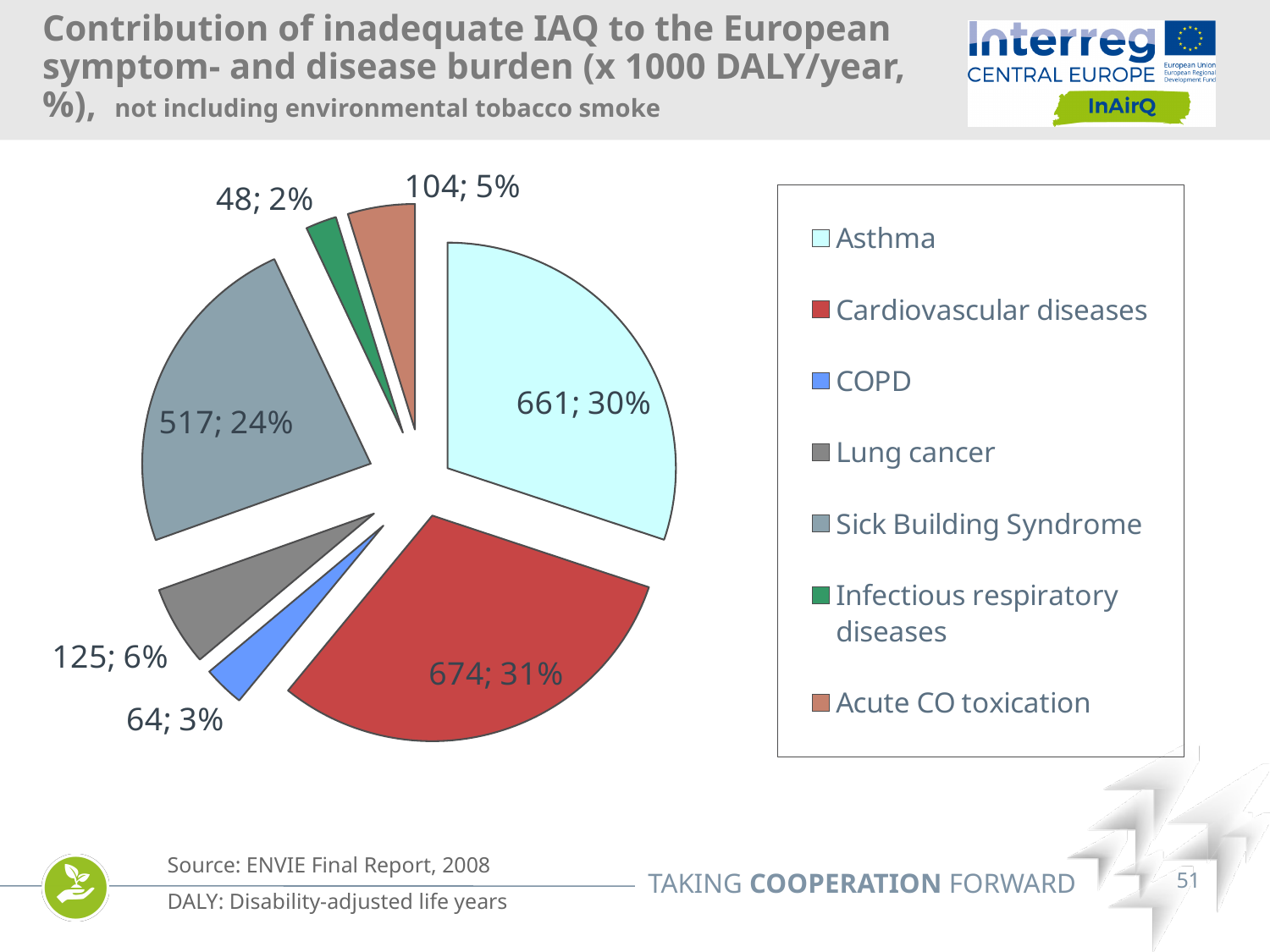
What is the difference between the values for Sick Building Syndrome and Lung cancer? 392 What value (x 1000 DALY/year) is shown for Asthma? 661 Which category has the smallest value? Infectious respiratory diseases What is the source cited for the chart data? ENVIE Final Report, 2008 What share of the pie does COPD account for? 3% What kind of chart is shown on the slide? Pie chart How many categories does the legend list? 7 What value (x 1000 DALY/year) is shown for Sick Building Syndrome? 517 What is the difference between the values for Cardiovascular diseases and Asthma? 13 Which category has the largest value? Cardiovascular diseases Which is larger, the value for Lung cancer or the value for Acute CO toxication? Lung cancer What share of the pie does Cardiovascular diseases account for? 31%